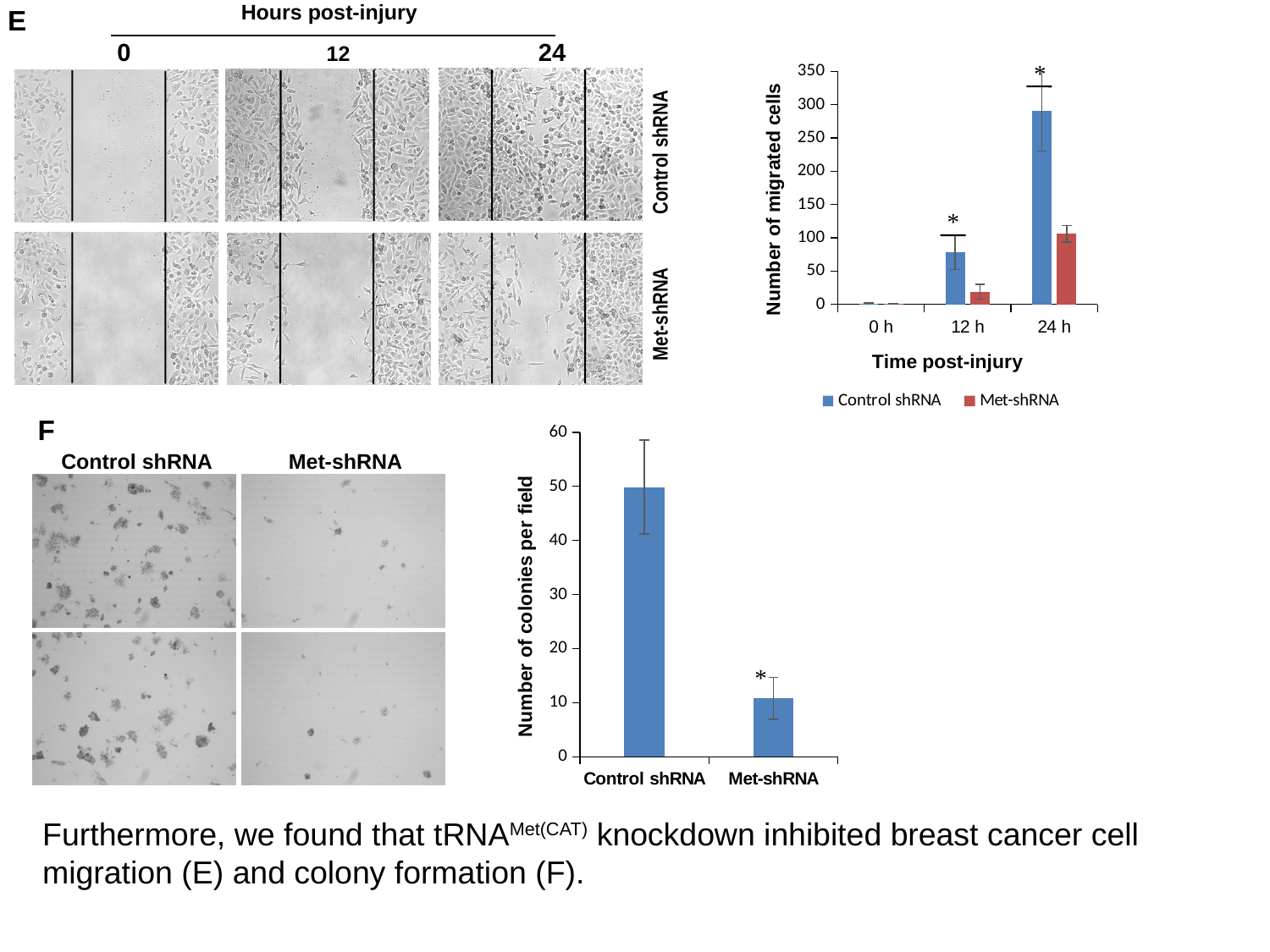
What kind of chart is the chart in panel F (bottom, 'Number of colonies per field')? bar chart In the panel E chart (Number of migrated cells), what is the title of the x axis? Time post-injury In the panel E chart (Number of migrated cells), which series has the higher value at 24 h, Control shRNA or Met-shRNA? Control shRNA In the panel E chart (Number of migrated cells), is the value for Control shRNA at 24 h greater or less than 250? greater In the panel E chart (Number of migrated cells), do the Control shRNA values rise or fall from 0 h to 24 h? rise In the panel F chart (Number of colonies per field), which category has the lowest value? Met-shRNA In the panel E chart (Number of migrated cells), is the value for Met-shRNA at 12 h greater or less than 50? less What kind of chart is the chart in panel E (top right, 'Number of migrated cells')? bar chart In the panel E chart (Number of migrated cells), is the value for Met-shRNA at 24 h greater or less than 150? less In the panel E chart (Number of migrated cells), how many series does the legend list? 2 In the panel E chart (Number of migrated cells), how many time points are shown on the x axis? 3